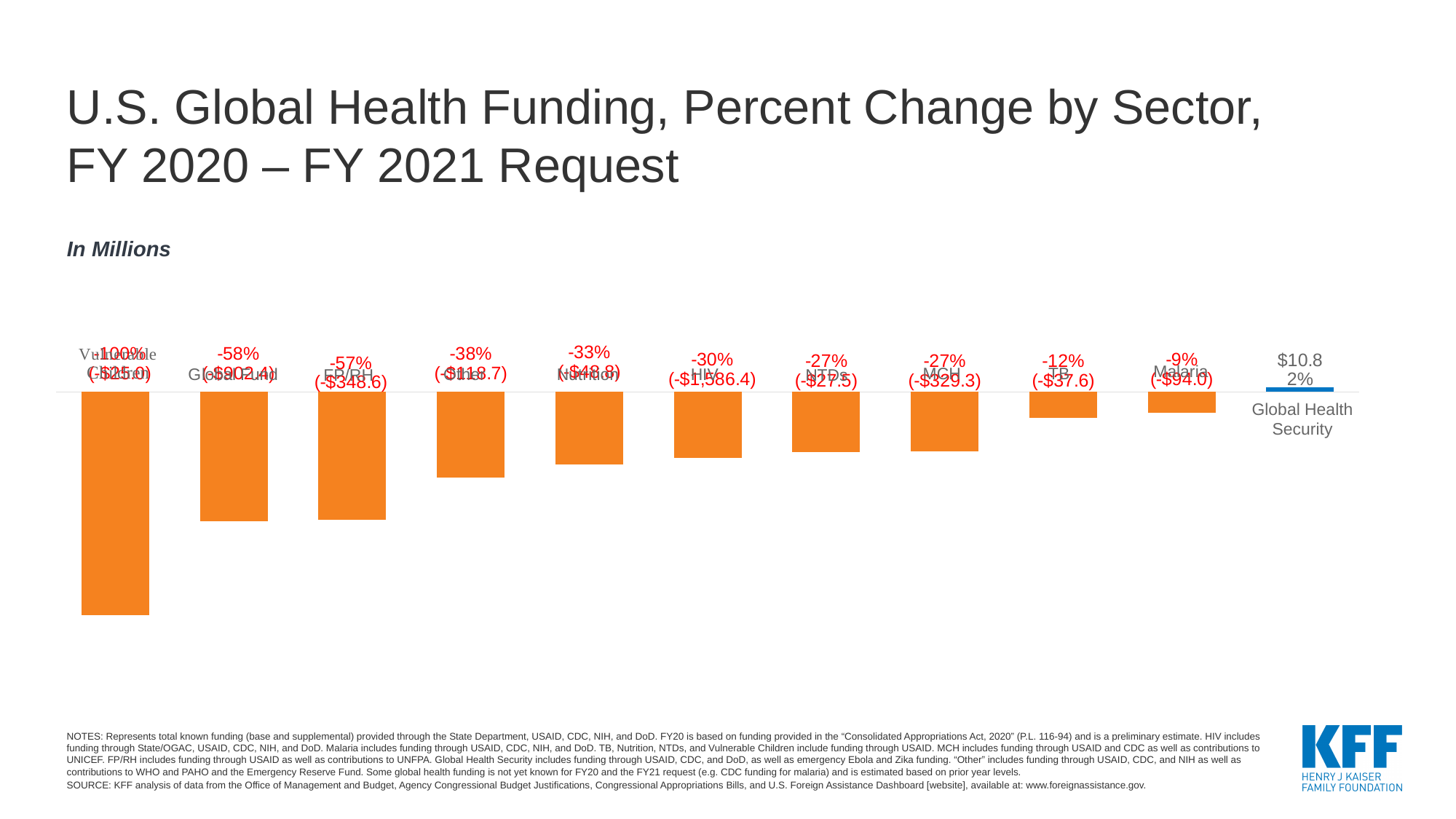
What is the dollar change shown for Global Health Security? $10.8 What is the dollar change shown for HIV? -$1,586.4 What is the percent change for HIV? -30% How many sectors are plotted in the chart? 11 Which sector has a larger percent decrease, TB or Malaria? TB What is the difference in percentage points between the percent change for HIV and for TB? 18 percentage points What is the percent change for Malaria? -9% Which sector has the largest percent decrease? Vulnerable Children What is the percent change for FP/RH? -57% Which sector is the only one with a positive percent change? Global Health Security What kind of chart is shown on the slide? Bar chart What is the percent change for Global Health Security? 2%